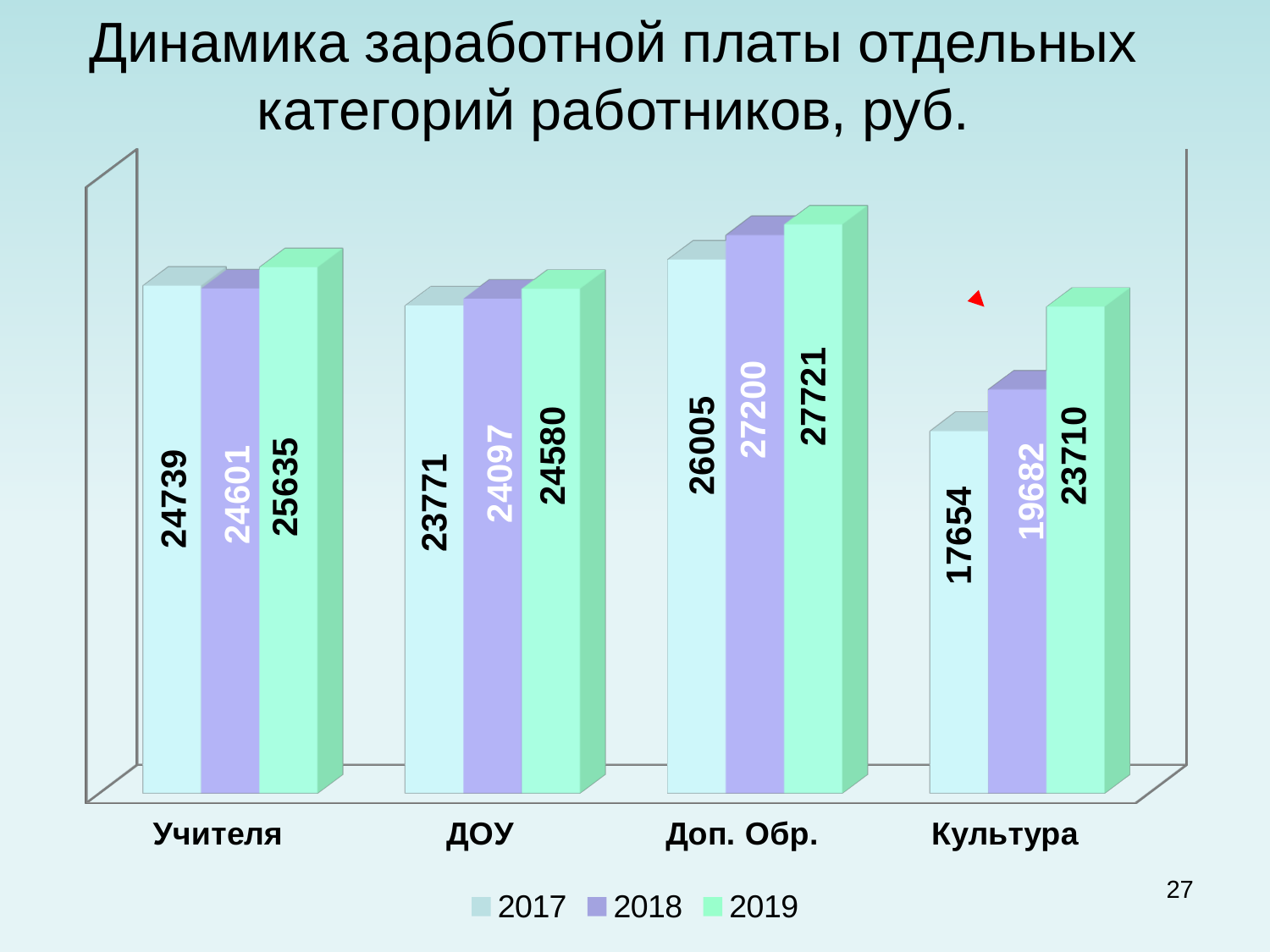
What is the difference between the 2018 and 2017 values for Доп. Обр.? 1195 What is the 2017 value for Культура? 17654 What is the 2019 value for Учителя? 25635 How many series does the legend list? 3 What is the title of the chart? Динамика заработной платы отдельных категорий работников, руб. What is the 2018 value for ДОУ? 24097 Which category has the lowest 2017 value? Культура What is the difference between the 2019 and 2017 values for Культура? 6056 How many categories are shown on the x axis? 4 Which is larger for Учителя: the 2017 value or the 2018 value? 2017 What kind of chart is shown on the slide? Bar chart Which category has the highest 2019 value? Доп. Обр.